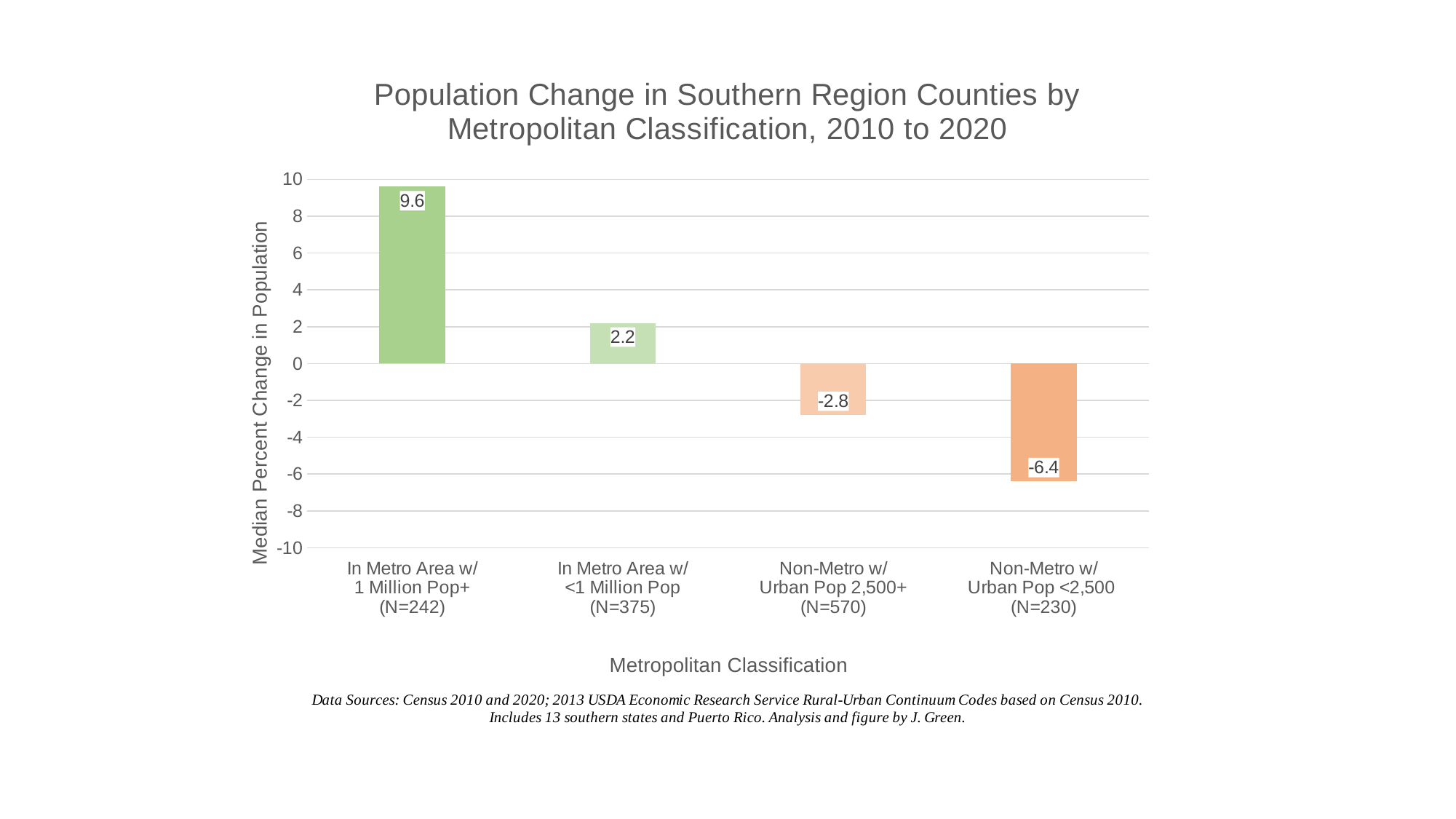
How many metropolitan classification categories are shown in the chart? 4 Which metropolitan classification has the highest median percent change in population? In Metro Area w/ 1 Million Pop+ (N=242) What kind of chart is shown on the slide? Bar chart Which metropolitan classification has the lowest median percent change in population? Non-Metro w/ Urban Pop <2,500 (N=230) What is the difference between the median percent change for non-metro counties with urban pop 2,500+ and non-metro counties with urban pop <2,500? 3.6 What is the difference between the median percent change for metro areas with 1 million pop+ and metro areas with <1 million pop? 7.4 Which has a larger median percent change in population: non-metro counties with urban pop 2,500+ or non-metro counties with urban pop <2,500? Non-Metro w/ Urban Pop 2,500+ (N=570) What is the median percent change in population for counties in a metro area with 1 million pop+ (N=242)? 9.6 What is the median percent change in population for counties in a metro area with <1 million pop (N=375)? 2.2 Do the values rise or fall moving from left to right across the metropolitan classifications? Fall What is the median percent change in population for non-metro counties with urban pop <2,500 (N=230)? -6.4 What is the median percent change in population for non-metro counties with urban pop 2,500+ (N=570)? -2.8